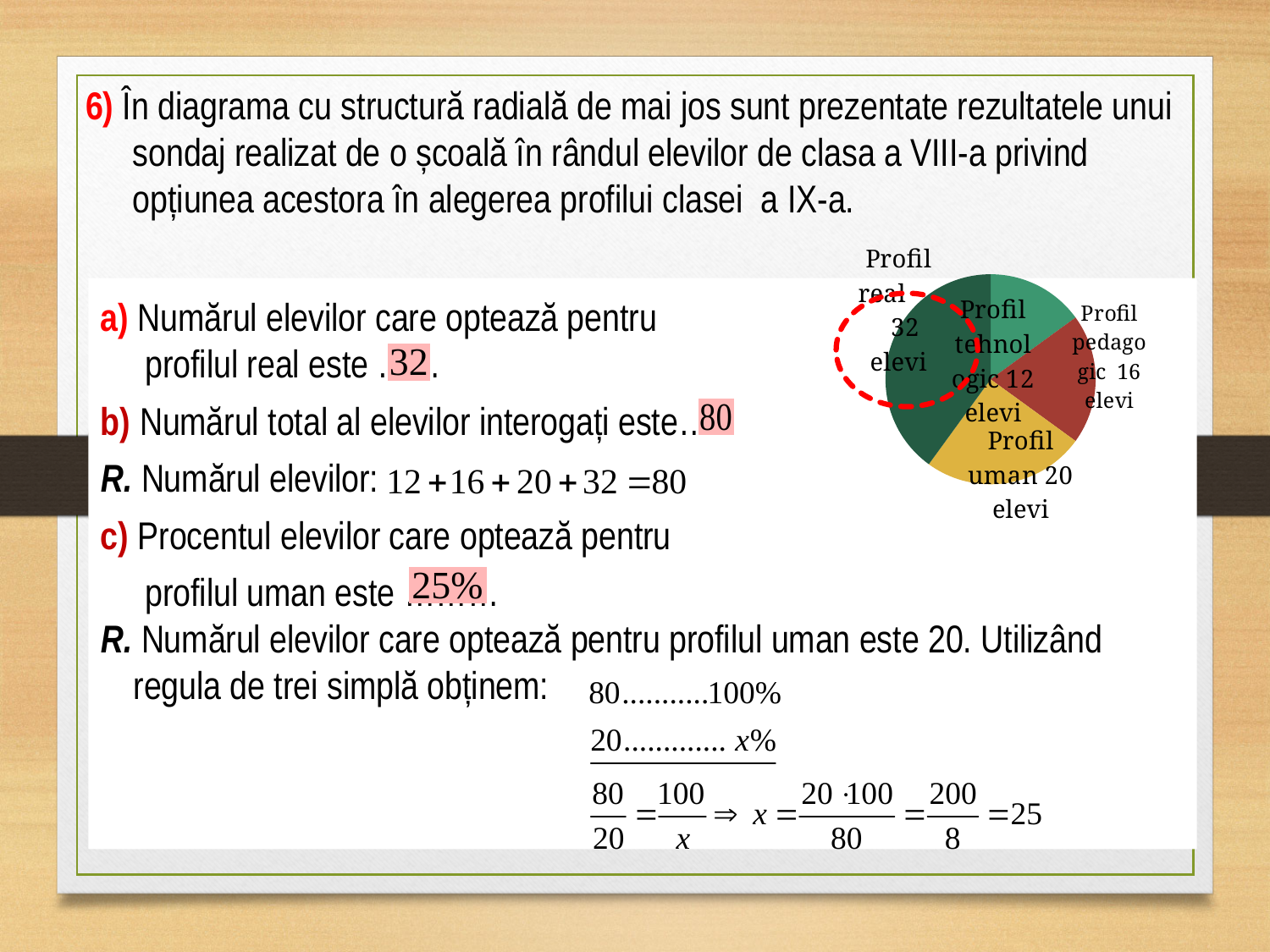
How many students chose Profil uman according to the pie chart? 20 elevi What kind of chart is shown on the slide? pie chart Which profile has the largest slice in the pie chart? Profil real How many students chose Profil tehnologic according to the pie chart? 12 elevi How many more students chose Profil real than Profil tehnologic? 20 Which profile has the smallest slice in the pie chart? Profil tehnologic How many students chose Profil real according to the pie chart? 32 elevi Which has more students, Profil uman or Profil pedagogic? Profil uman How many slices does the pie chart have? 4 What share of all surveyed students chose Profil real? 40% How many students chose Profil pedagogic according to the pie chart? 16 elevi What share of all surveyed students chose Profil uman? 25%